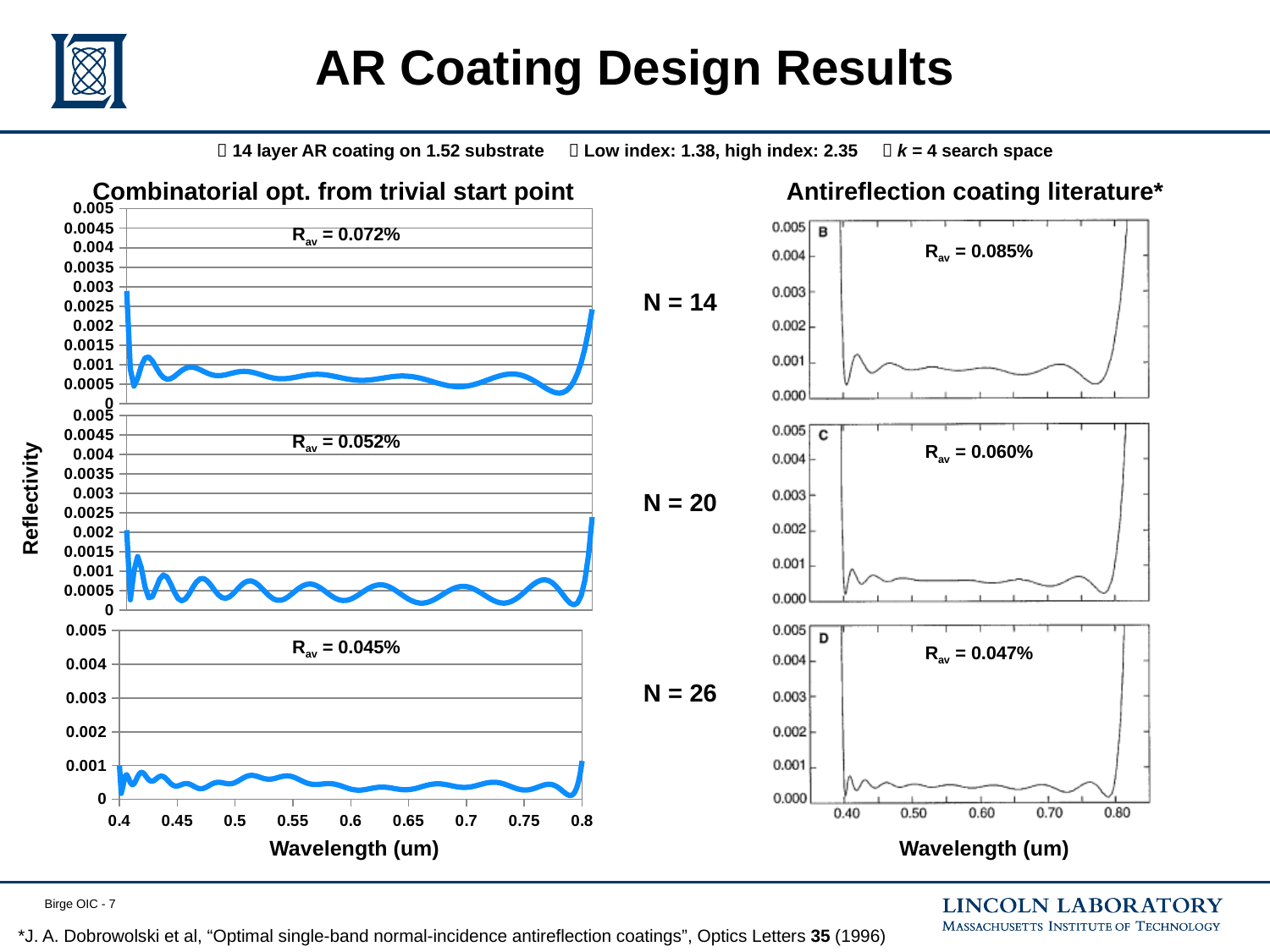
In the right column (Antireflection coating literature), what is the R_av value shown on chart C? 0.060% What is the difference between the R_av of literature chart B (0.085%) and the combinatorial N = 14 chart (0.072%)? 0.013% What kind of chart is used to show reflectivity versus wavelength on this slide? Line chart In the right column (Antireflection coating literature), what is the R_av value shown on chart B? 0.085% In the combinatorial N = 26 chart, is the reflectivity at a wavelength of 0.6 um greater or less than 0.001? less In the left column (Combinatorial opt. from trivial start point), what is the R_av value shown on the N = 14 chart? 0.072% For N = 14, which has the lower R_av: the combinatorial optimization chart on the left or literature chart B on the right? Combinatorial optimization (0.072%) In the left column (Combinatorial opt. from trivial start point), what is the R_av value shown on the N = 26 chart? 0.045% What is the difference between the R_av of literature chart D and the combinatorial N = 26 chart? 0.002% In the left column, does R_av rise or fall as N increases from 14 to 26? Fall In the left column (Combinatorial opt. from trivial start point), what is the R_av value shown on the N = 20 chart? 0.052% In the right column (Antireflection coating literature), what is the R_av value shown on chart D? 0.047%